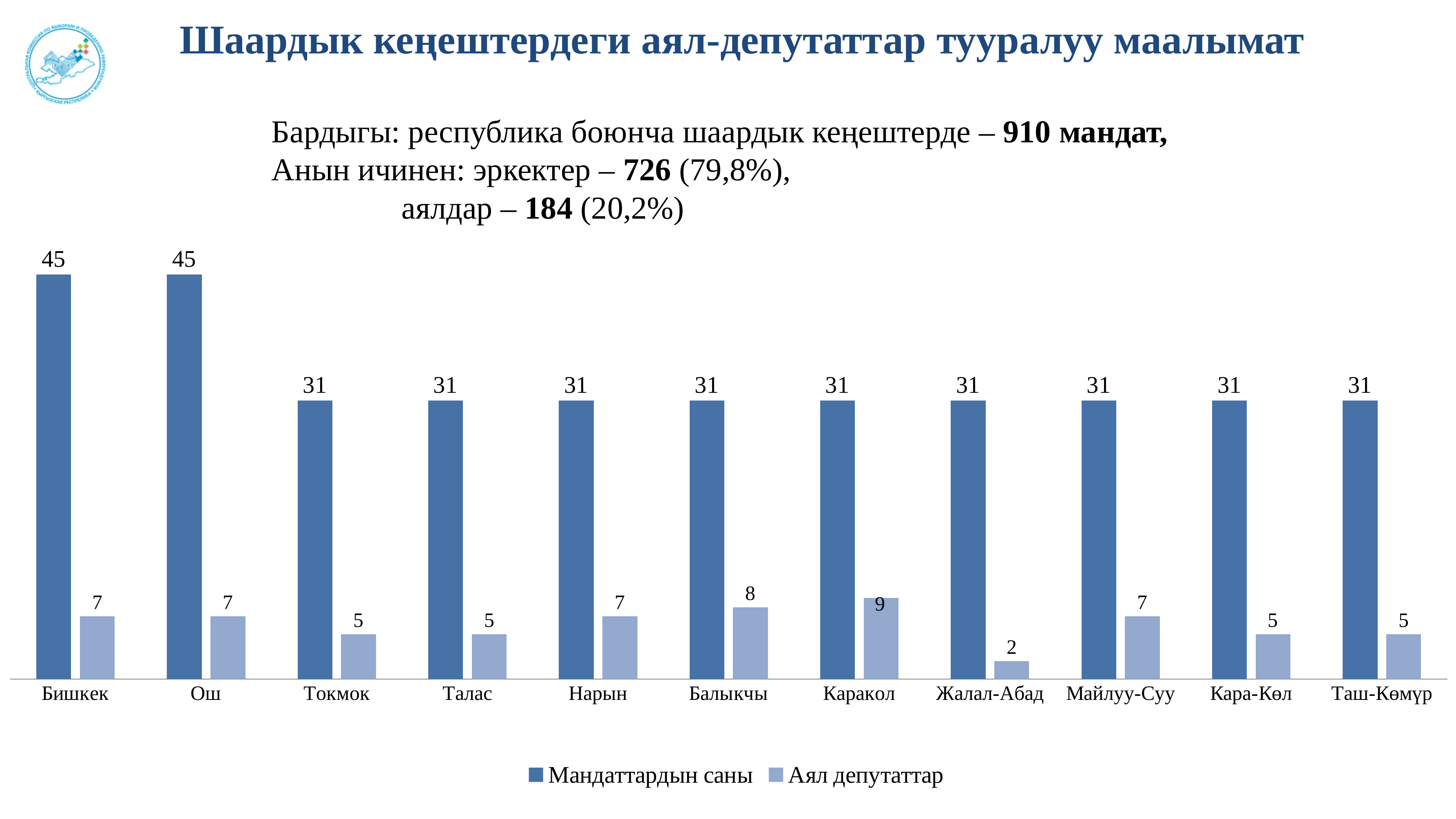
What is the value of "Аял депутаттар" for Каракол? 9 What kind of chart is shown on the slide? Bar chart What is the value of "Мандаттардын саны" for Токмок? 31 How many cities are shown on the x axis of the chart? 11 What is the value of "Аял депутаттар" for Жалал-Абад? 2 Which is larger: "Аял депутаттар" for Балыкчы or for Нарын? Балыкчы How many series does the chart legend list? 2 Which city has the highest value for "Аял депутаттар"? Каракол What are the two series named in the chart legend? Мандаттардын саны and Аял депутаттар Which city has the lowest value for "Аял депутаттар"? Жалал-Абад What is the value of "Мандаттардын саны" for Бишкек? 45 What is the difference between "Мандаттардын саны" and "Аял депутаттар" for Ош? 38